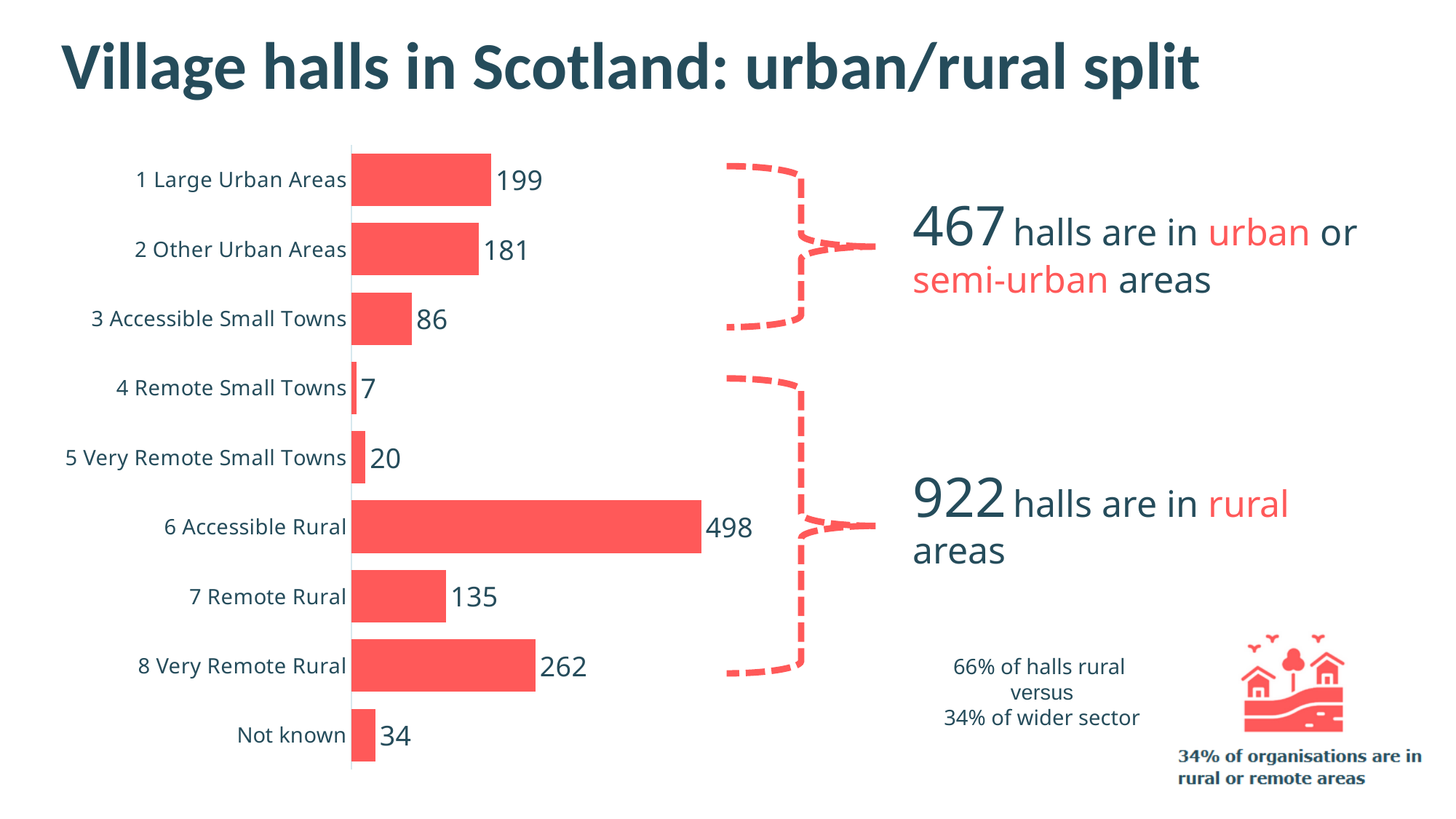
Which category has the lowest value? 4 Remote Small Towns What is the value for 4 Remote Small Towns? 7 What kind of chart is shown on the slide? Bar chart Which category has the highest value? 6 Accessible Rural What is the title of the slide containing the chart? Village halls in Scotland: urban/rural split Which is larger, the value for 3 Accessible Small Towns or the value for 5 Very Remote Small Towns? 3 Accessible Small Towns What is the difference between the values for 1 Large Urban Areas and 2 Other Urban Areas? 18 What is the difference between the values for 8 Very Remote Rural and 7 Remote Rural? 127 How many categories are shown in the chart? 9 What is the value for Not known? 34 What is the value for 6 Accessible Rural? 498 What is the value for 1 Large Urban Areas? 199